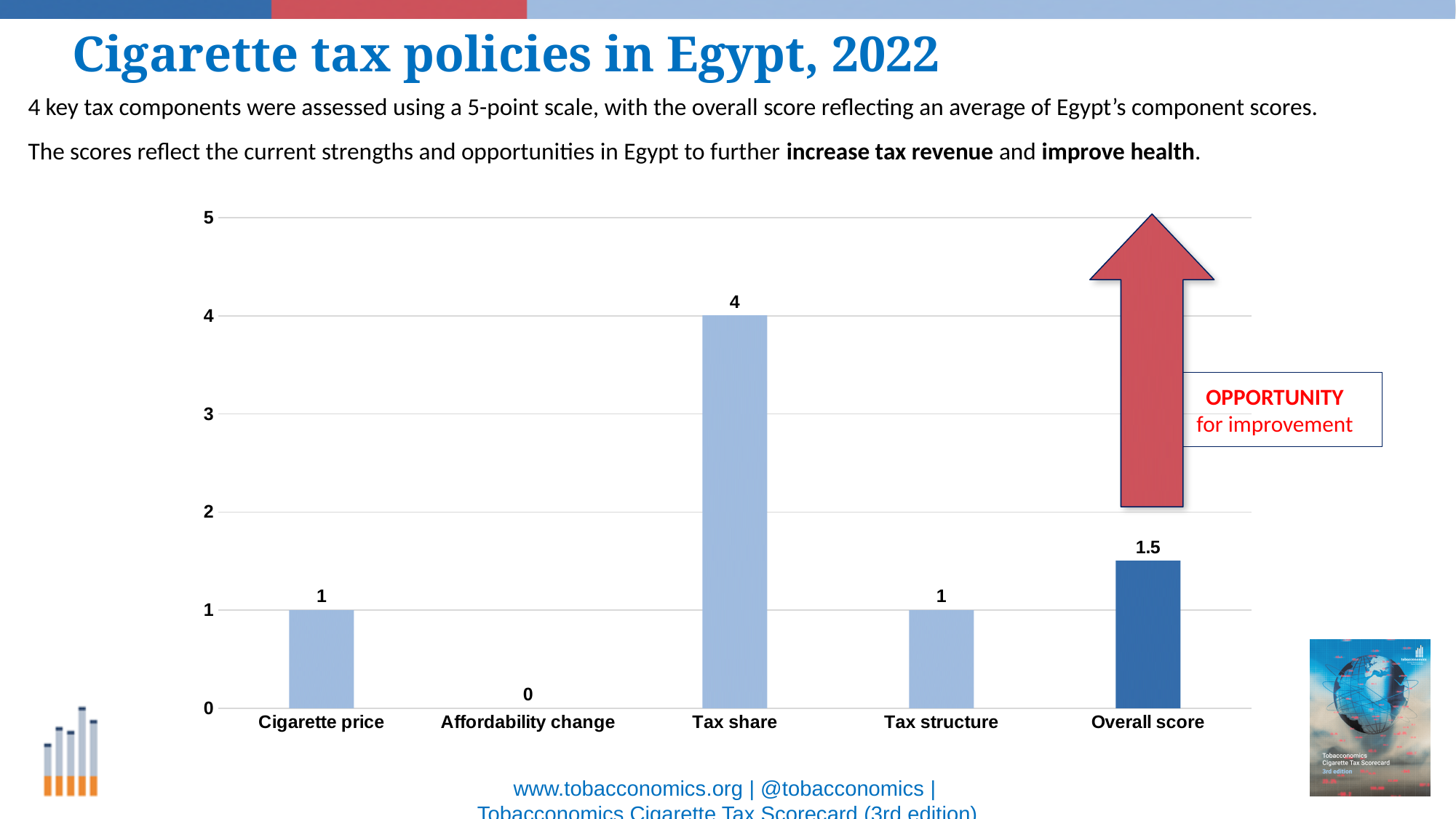
What is the highest value shown on the y axis? 5 Which is larger, the value for Overall score or the value for Cigarette price? Overall score What is the difference between the values for Tax share and Tax structure? 3 What is the value for Affordability change? 0 What is the value for Cigarette price? 1 How many categories are shown on the x axis? 5 What is the value for Tax share? 4 Is the value for Tax share greater or less than 3? greater What kind of chart is shown on the slide? bar chart Which category has the highest value? Tax share Which category has the lowest value? Affordability change What is the value for Overall score? 1.5